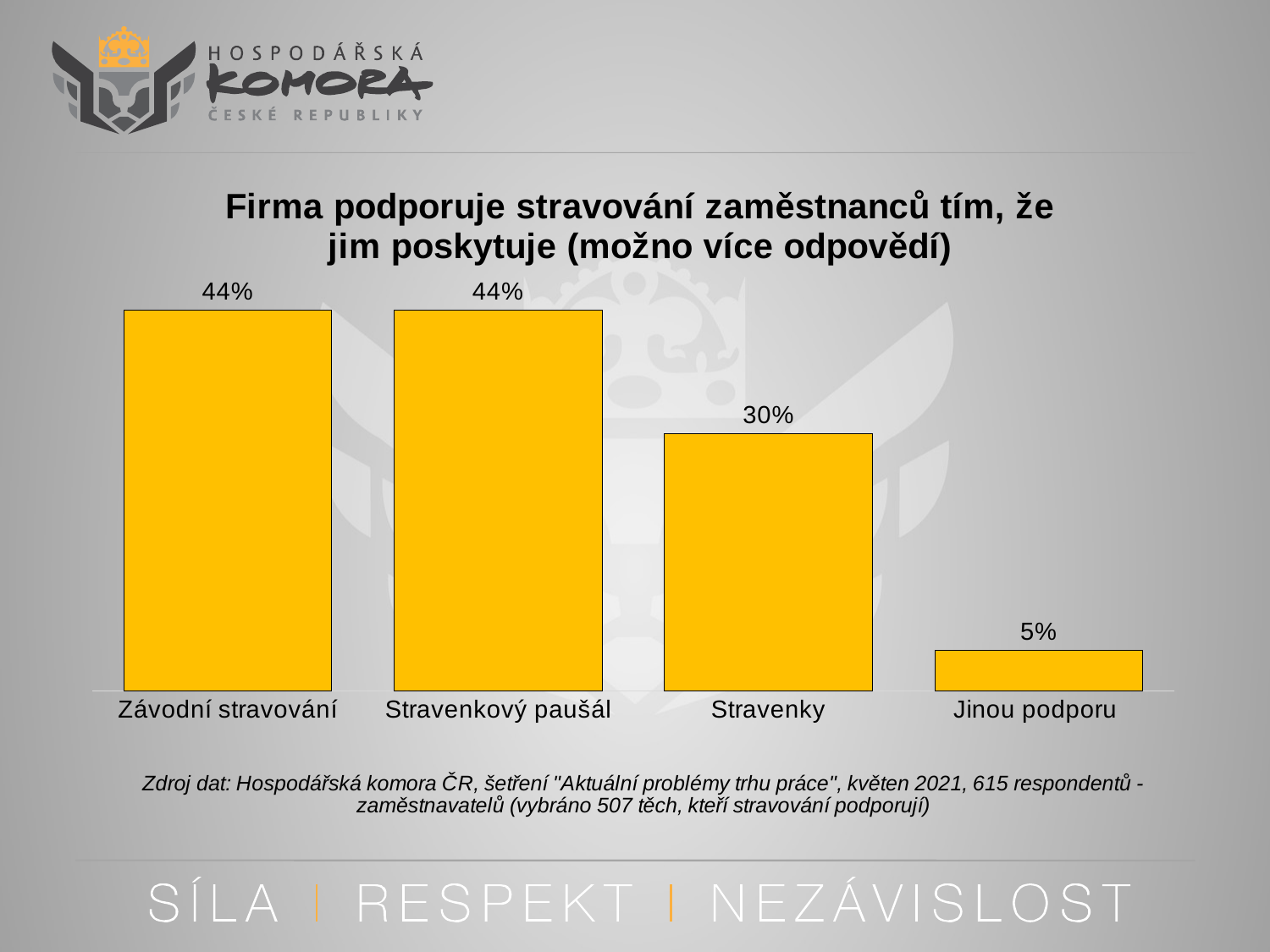
How many categories are shown in the chart? 4 What is the value for Stravenky? 30% Which is larger, the value for Stravenky or the value for Jinou podporu? Stravenky What is the difference between the values for Závodní stravování and Stravenky? 14% What is the difference between the values for Stravenky and Jinou podporu? 25% What is the title of the chart? Firma podporuje stravování zaměstnanců tím, že jim poskytuje (možno více odpovědí) What kind of chart is shown on the slide? Bar chart What is the value for Jinou podporu? 5% What is the value for Stravenkový paušál? 44% What is the value for Závodní stravování? 44% Do the values rise or fall from left to right across the categories? Fall Which category has the lowest value? Jinou podporu